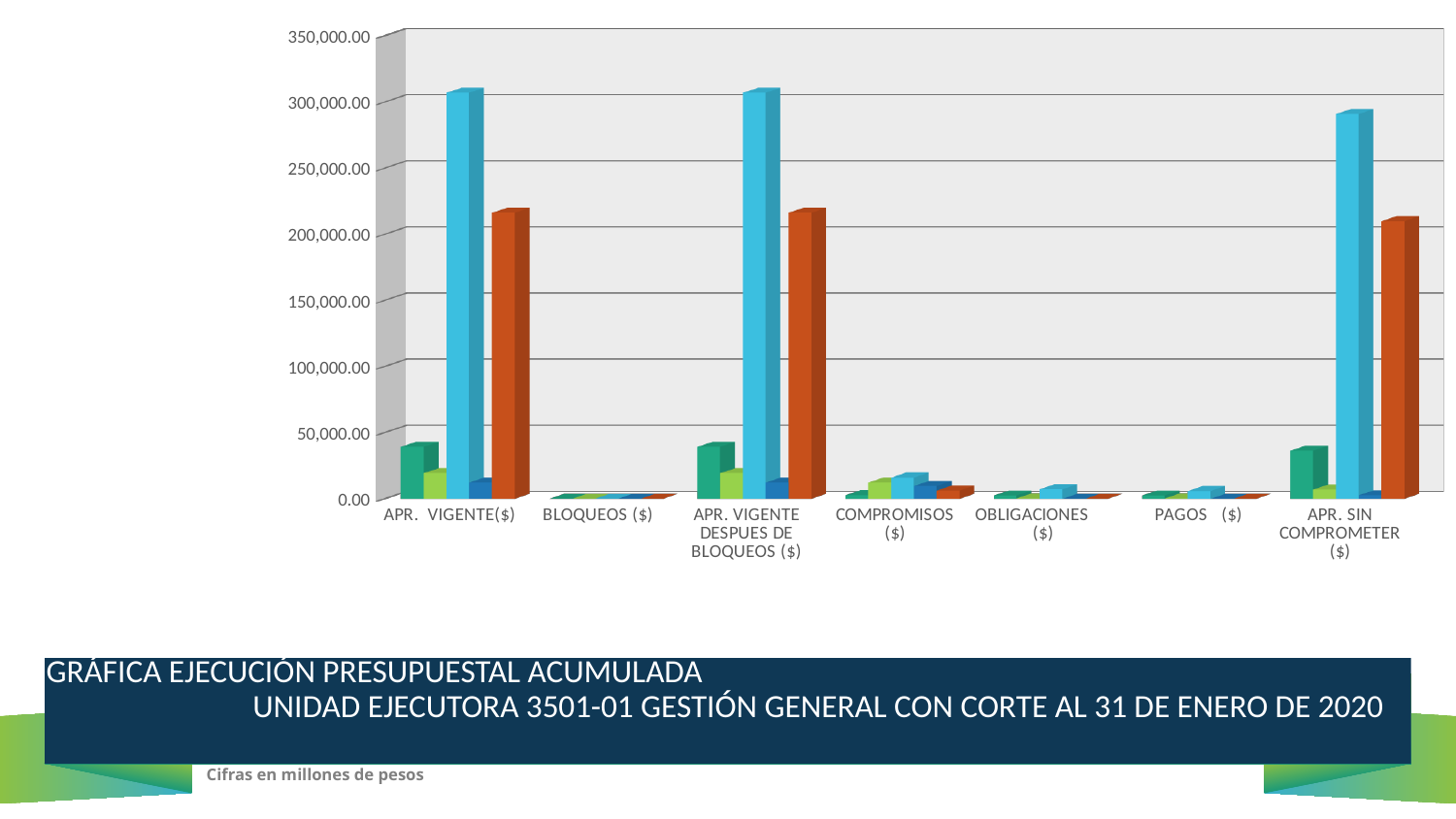
What is the highest value shown on the vertical axis of the chart? 350,000.00 How many categories are shown along the x axis of the chart? 7 Is the value of the dark green bar for APR. VIGENTE($) greater or less than 50,000.00? less Is the value of the tallest (cyan) bar for APR. VIGENTE($) greater or less than 250,000.00? greater For APR. VIGENTE($), which bar is taller: the cyan bar or the orange bar? the cyan bar Which category has the lowest bars overall in the chart? BLOQUEOS ($) Is the value of the tallest (cyan) bar for APR. SIN COMPROMETER ($) greater or less than 250,000.00? greater According to the note below the chart, in what units are the figures expressed? Cifras en millones de pesos What kind of chart is shown on the slide? bar chart